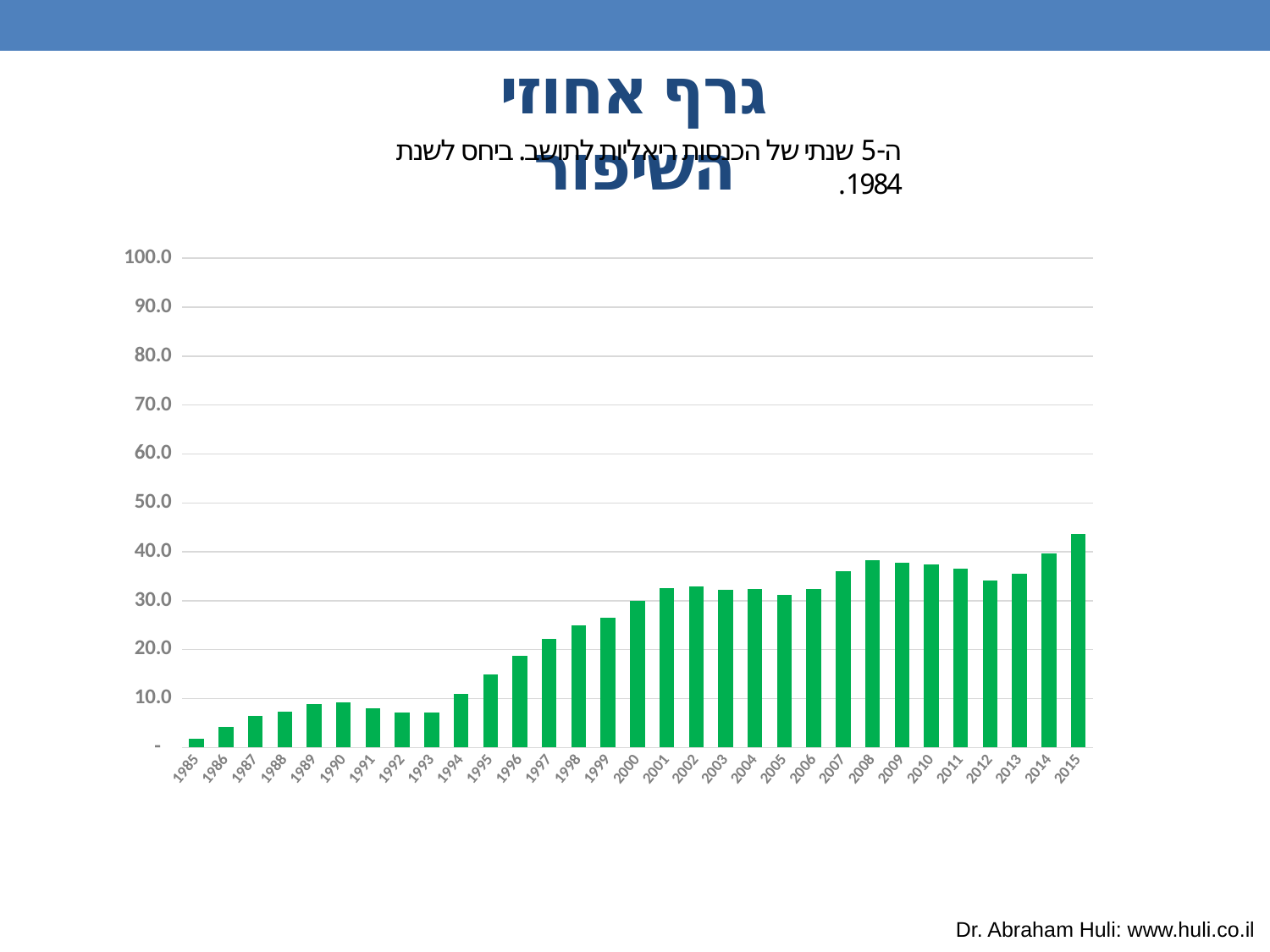
Overall, do the values rise or fall from 1985 to 2015? rise What is the highest tick value shown on the vertical axis? 100.0 How many years (bars) are plotted on the chart? 31 Which year has the larger value, 1990 or 1993? 1990 Is the value for 2015 greater or less than 40.0? greater Which year has the lowest bar on the chart? 1985 Which year has the highest bar on the chart? 2015 Is the value for 1996 greater or less than 20.0? less Is the value for 1985 greater or less than 10.0? less What kind of chart is shown on the slide? bar chart Which year has the larger value, 2008 or 2012? 2008